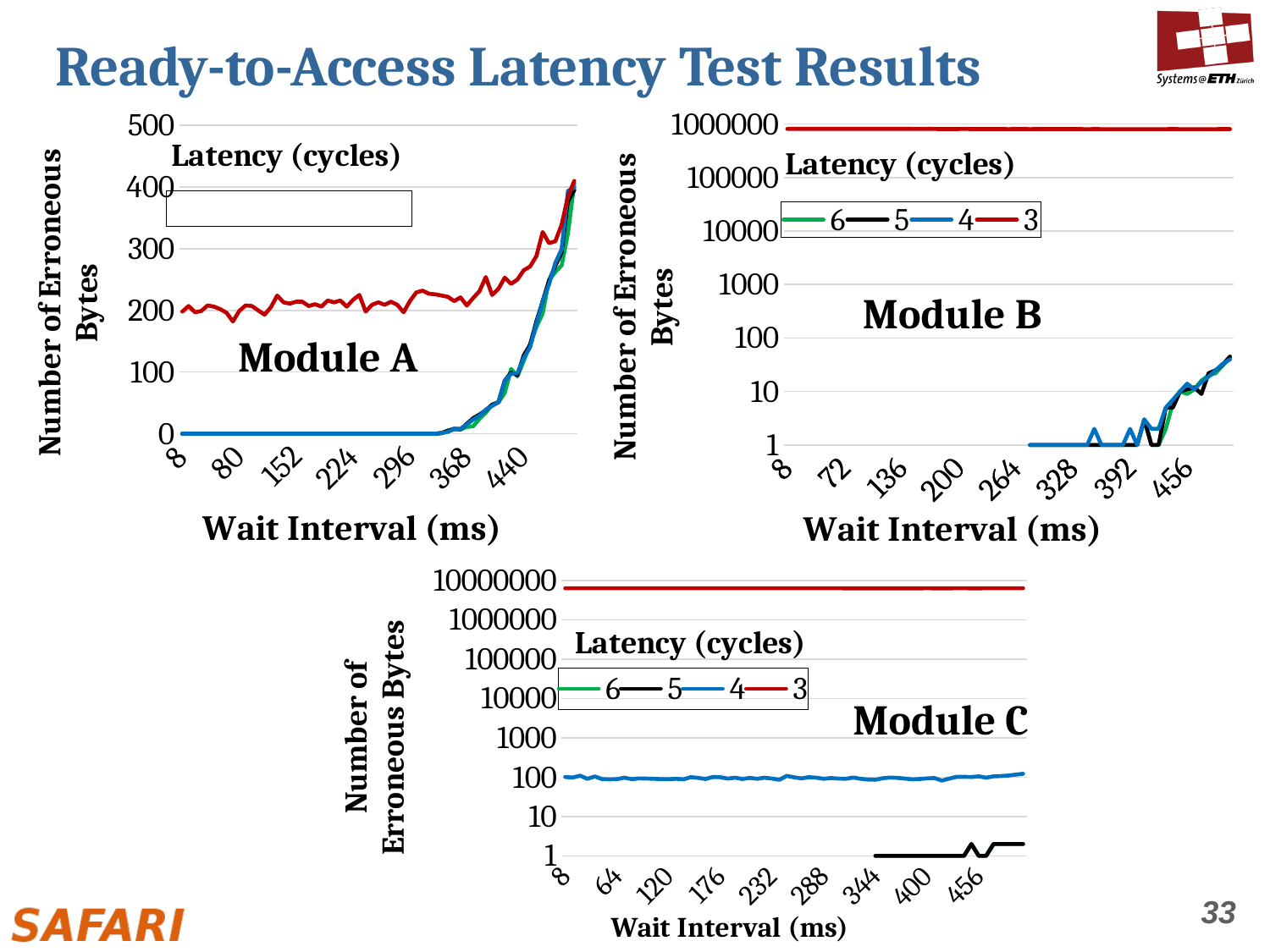
How many series does the legend of the Module B chart list? 4 What is the x-axis title of the Module B chart? Wait Interval (ms) In the Module C chart, is the value of the blue line (latency 4) at wait interval 8 greater or less than 1000? less In the Module C chart, is the value of the black line (latency 5) at wait interval 400 greater or less than 10? less In the Module A chart, do the blue, green and black lines rise or fall as the wait interval increases toward 440 and beyond? rise In the Module B chart, which latency series has the highest number of erroneous bytes? 3 What is the title of the legend in the Module C chart? Latency (cycles) What kind of chart is the Module A chart? line chart In the Module A chart, is the value of the red line (latency 3) at wait interval 8 greater or less than 100? greater